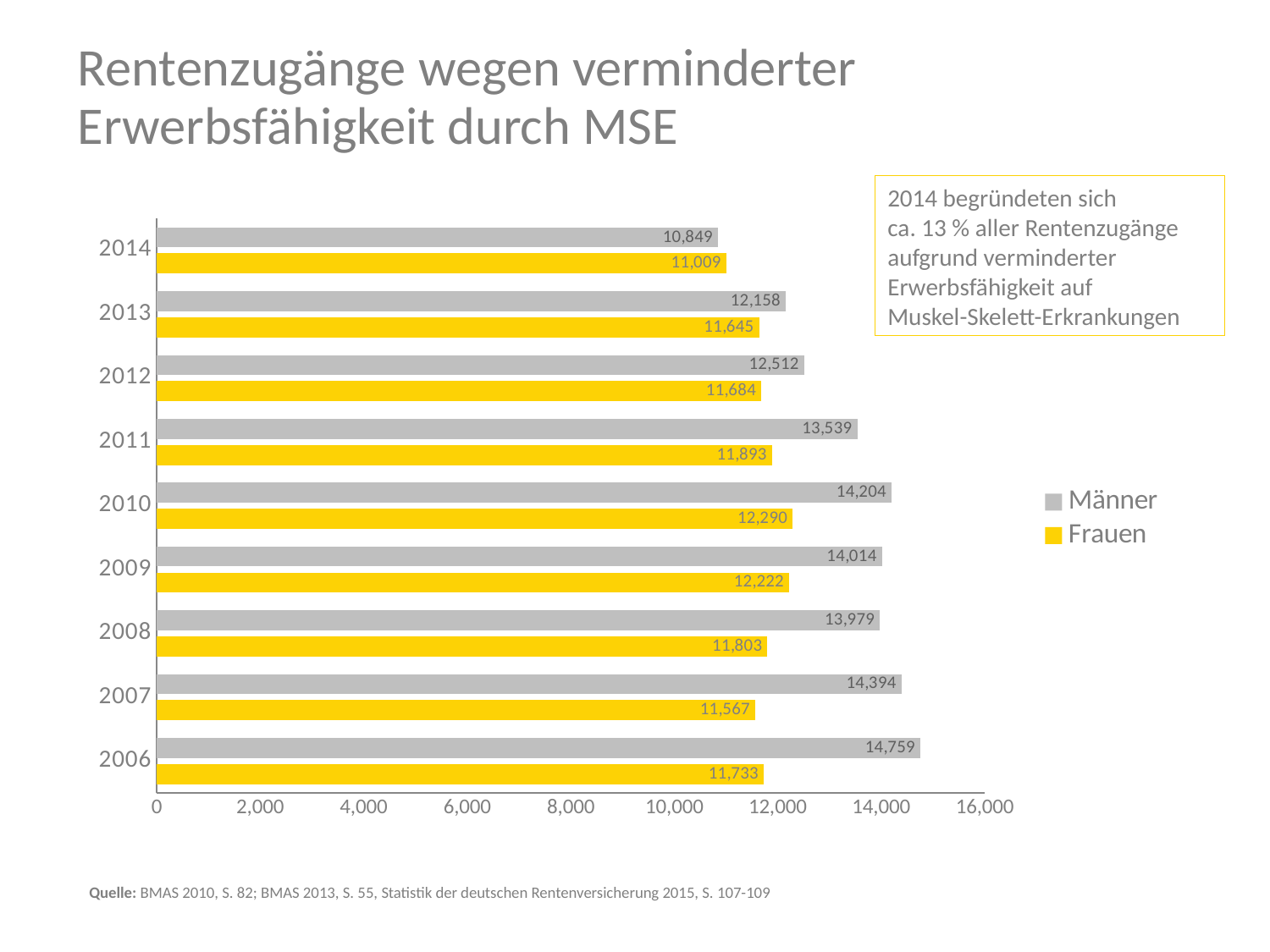
What is the difference between the Männer and Frauen values in 2006? 3,026 In which year is the Männer value highest? 2006 How many years are shown on the chart? 9 In which year is the Frauen value lowest? 2014 Is the Männer value for 2011 greater or less than 12,000? greater In 2014, which is larger: the Männer value or the Frauen value? Frauen Which colour represents Frauen in the chart? Yellow What is the value for Männer in 2014? 10,849 What is the value for Männer in 2006? 14,759 What kind of chart is shown on the slide? Bar chart How many series does the legend list? 2 What is the value for Frauen in 2010? 12,290